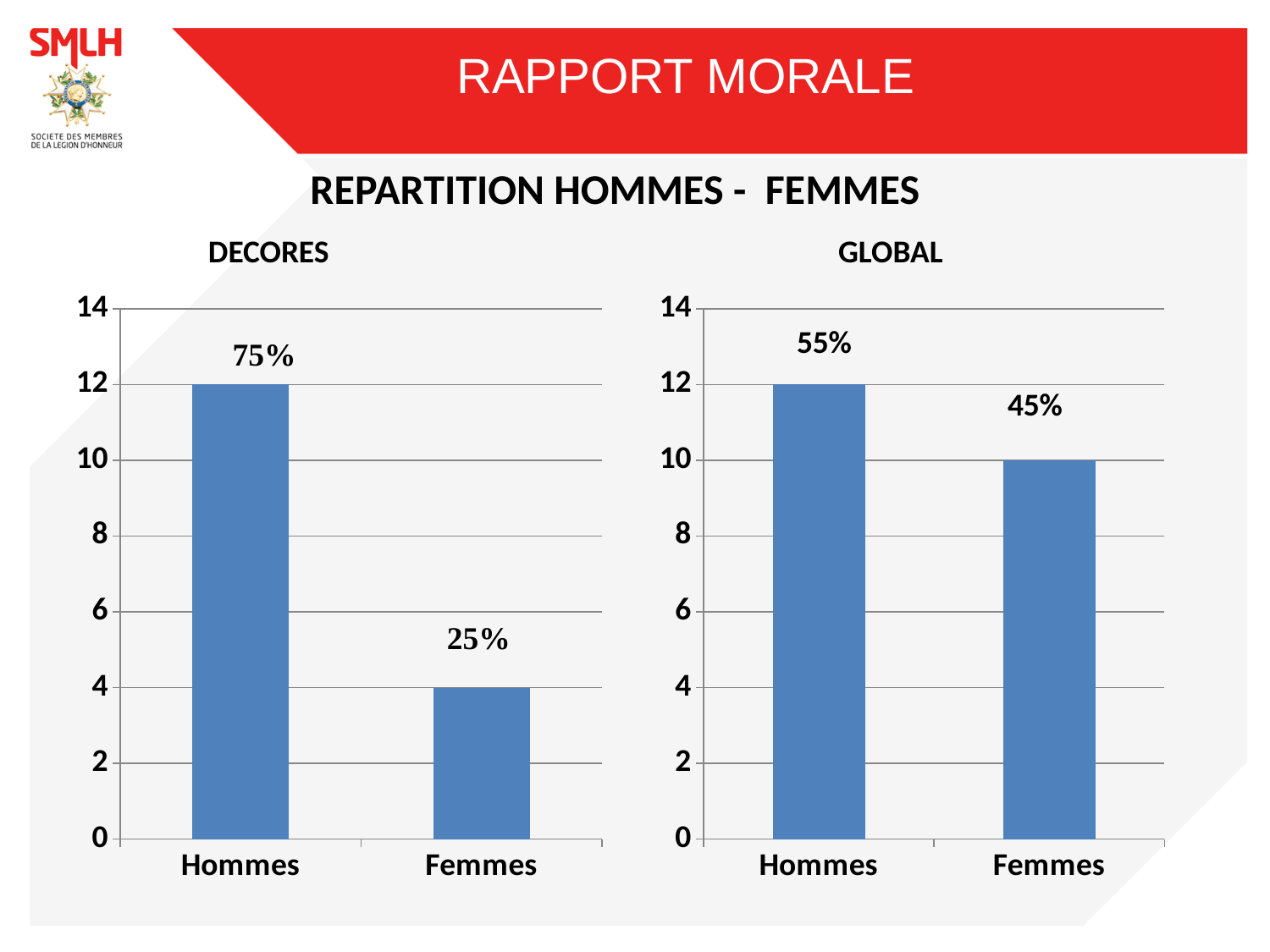
In the DECORES chart, what data label is shown above the Hommes bar? 75% In the DECORES chart, what value on the vertical axis does the Femmes bar reach? 4 In the GLOBAL chart, which category has the shortest bar? Femmes What type of chart is the DECORES chart? Bar chart In the GLOBAL chart, is the Femmes bar greater or less than 8 on the vertical axis? greater In the DECORES chart, which category has the tallest bar? Hommes In the GLOBAL chart, what value on the vertical axis does the Femmes bar reach? 10 How many categories are shown on the x axis of the GLOBAL chart? 2 In the DECORES chart, what is the difference between the Hommes bar (12) and the Femmes bar (4) on the vertical axis? 8 In the GLOBAL chart, what data label is shown above the Femmes bar? 45% In the GLOBAL chart, what data label is shown above the Hommes bar? 55% In the DECORES chart, what data label is shown above the Femmes bar? 25%